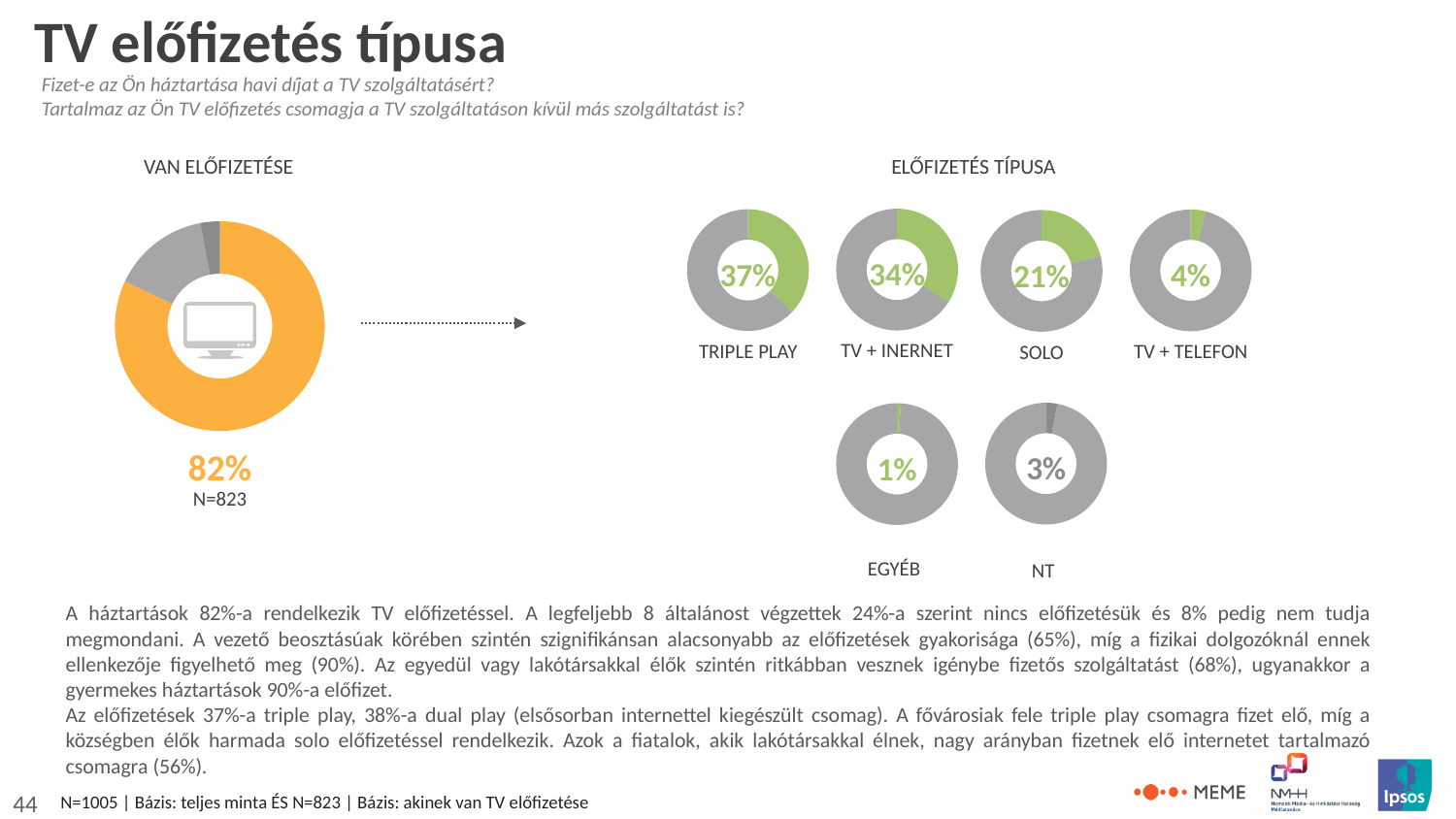
In the 'ELŐFIZETÉS TÍPUSA' charts, which subscription type has the lowest value? EGYÉB What kind of chart is used for 'VAN ELŐFIZETÉSE'? Donut (pie) chart In the 'ELŐFIZETÉS TÍPUSA' charts, what is the value for TV + INERNET? 34% In the 'ELŐFIZETÉS TÍPUSA' charts, what is the value for TV + TELEFON? 4% In the 'VAN ELŐFIZETÉSE' chart, what percentage is shown for households with a TV subscription? 82% In the 'ELŐFIZETÉS TÍPUSA' charts, what is the difference between TRIPLE PLAY and SOLO? 16% In the 'ELŐFIZETÉS TÍPUSA' charts, what is the value for TRIPLE PLAY? 37% In the 'ELŐFIZETÉS TÍPUSA' charts, what is the value for SOLO? 21% In the 'ELŐFIZETÉS TÍPUSA' charts, what is the value for NT? 3% How many subscription-type donut charts are shown under 'ELŐFIZETÉS TÍPUSA'? 6 In the 'ELŐFIZETÉS TÍPUSA' charts, which subscription type has the highest value? TRIPLE PLAY In the 'VAN ELŐFIZETÉSE' chart, what sample size (N) is shown below the percentage? N=823